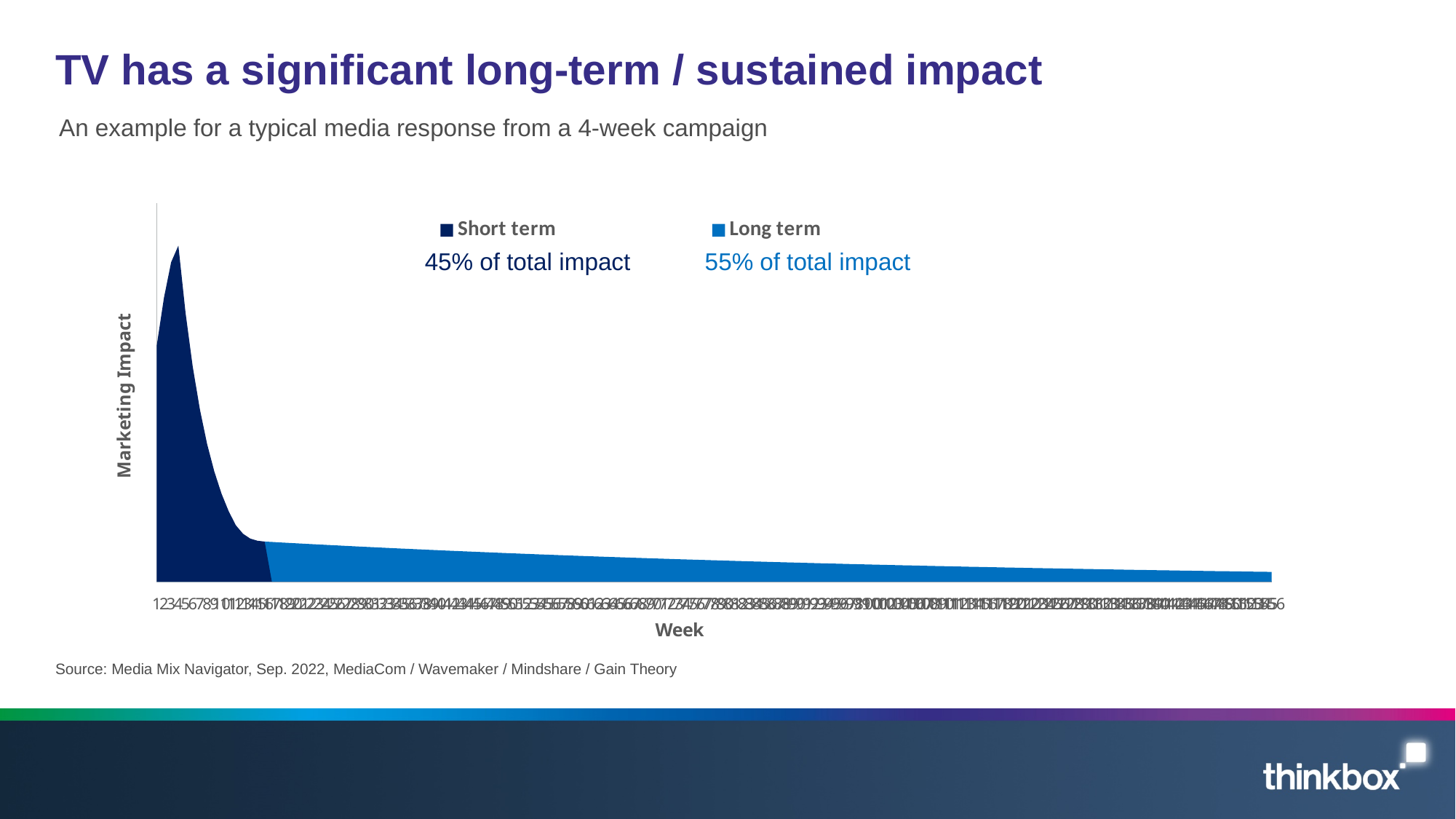
What are the two series named in the chart legend? Short term and Long term Which series accounts for the larger share of total impact, Short term or Long term? Long term Which series is shown in the dark navy colour? Short term Does the marketing impact rise or fall as the weeks progress along the x axis? Fall What share of total impact is attributed to the Short term series? 45% of total impact What is the label on the vertical axis of the chart? Marketing Impact Is the Short term share of total impact greater or less than 50%? less By how many percentage points does the Long term share of total impact exceed the Short term share? 10 percentage points What kind of chart is shown on the slide? Area chart What share of total impact is attributed to the Long term series? 55% of total impact Is the Long term share of total impact greater or less than 50%? greater How many series does the chart legend list? 2